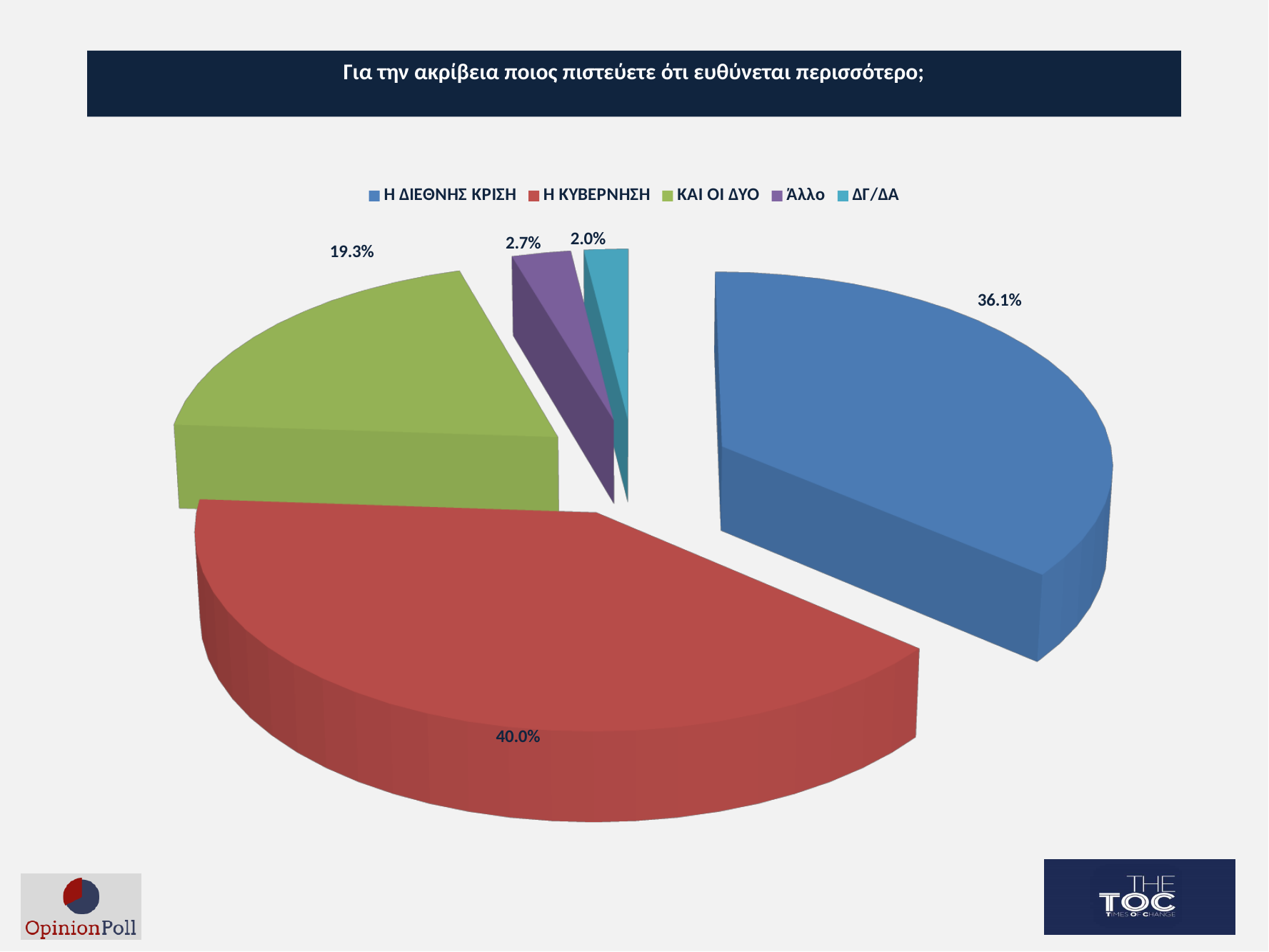
What is the value for Άλλο? 2.7% What is the value for Η ΔΙΕΘΝΗΣ ΚΡΙΣΗ? 36.1% What colour is the slice for ΚΑΙ ΟΙ ΔΥΟ? Green What is the value for Η ΚΥΒΕΡΝΗΣΗ? 40.0% Which category has the largest share of the pie? Η ΚΥΒΕΡΝΗΣΗ What is the difference between the values for Η ΚΥΒΕΡΝΗΣΗ and Η ΔΙΕΘΝΗΣ ΚΡΙΣΗ? 3.9% How many categories does the legend list? 5 Which is larger, the value for ΚΑΙ ΟΙ ΔΥΟ or the value for Άλλο? ΚΑΙ ΟΙ ΔΥΟ What kind of chart is shown on the slide? Pie chart Which category has the smallest share of the pie? ΔΓ/ΔΑ What is the value for ΔΓ/ΔΑ? 2.0% What is the value for ΚΑΙ ΟΙ ΔΥΟ? 19.3%